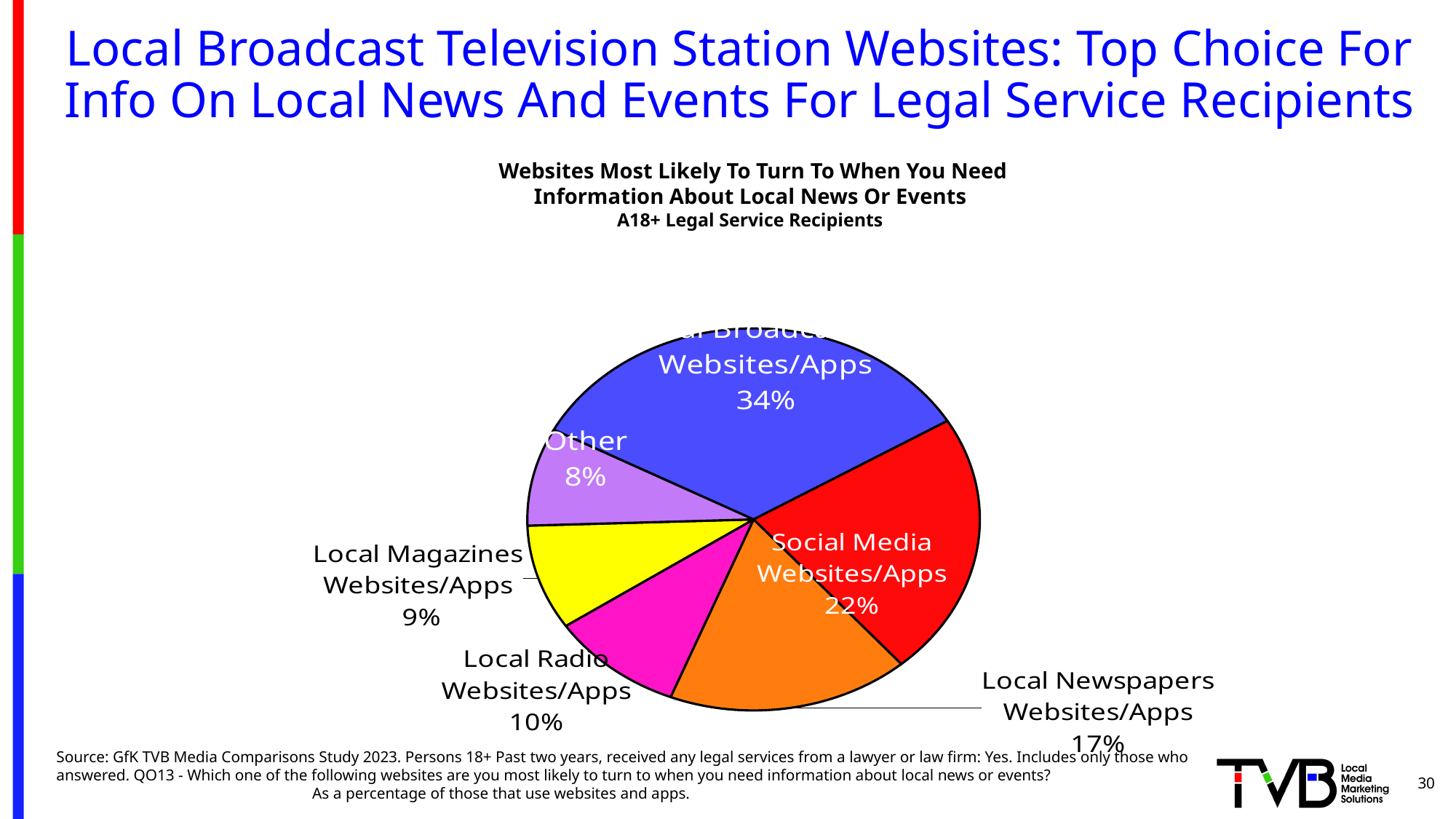
Which is larger, Local Radio Websites/Apps or Local Magazines Websites/Apps? Local Radio Websites/Apps What percentage is shown for Local Newspapers Websites/Apps? 17% What colour is the Social Media Websites/Apps slice? red What percentage is shown for Local Magazines Websites/Apps? 9% What percentage is shown for Social Media Websites/Apps? 22% Which category has the smallest share of the pie? Other What percentage is shown for the largest (blue) slice, Local Broadcast TV Websites/Apps? 34% What percentage is shown for the Other slice? 8% How many slices does the pie chart have? 6 What percentage is shown for Local Radio Websites/Apps? 10% What is the difference in percentage points between Social Media Websites/Apps and Local Newspapers Websites/Apps? 5 What kind of chart is shown on the slide? pie chart